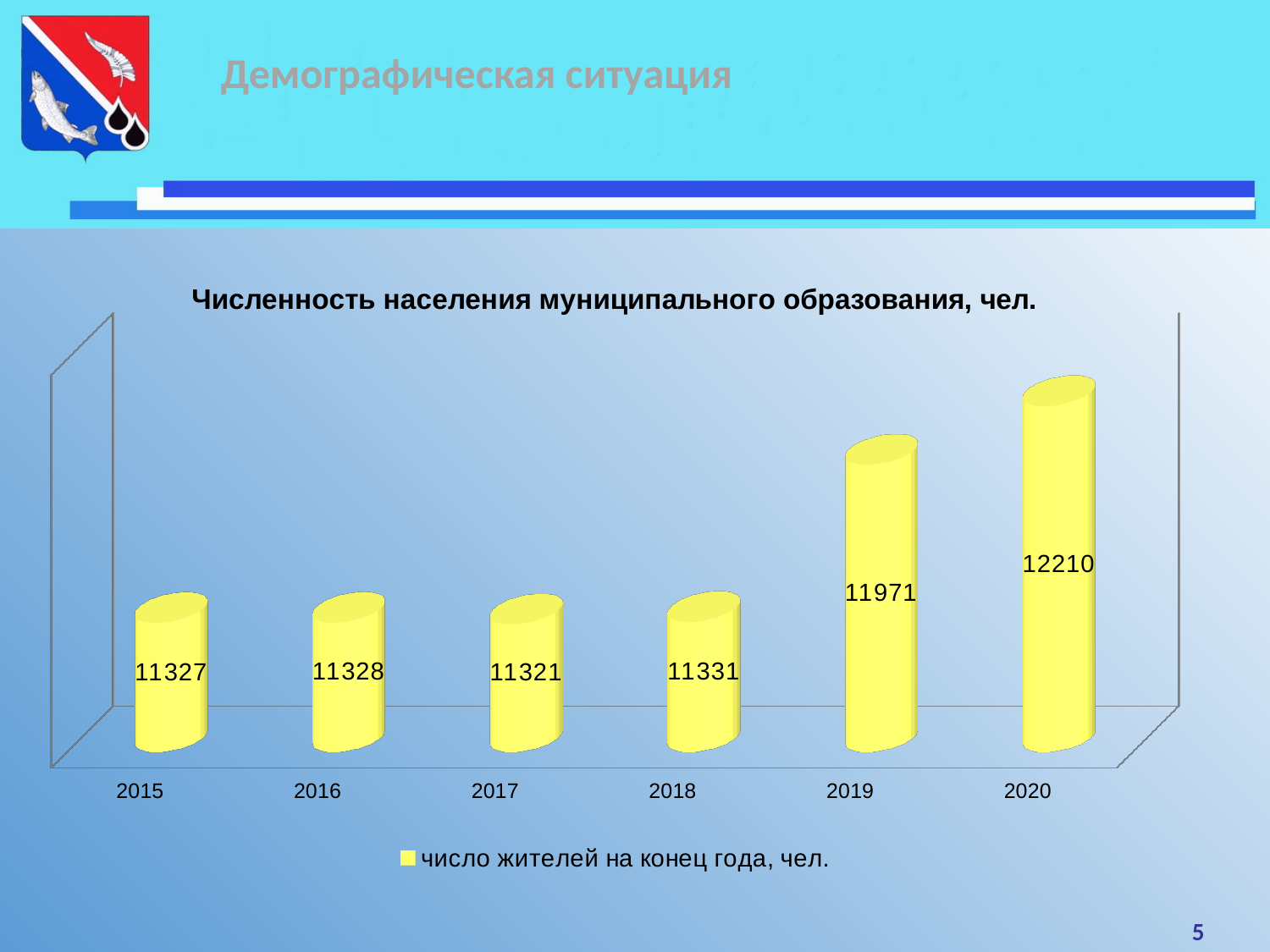
Which year has the highest population value? 2020 What is the population value shown for 2019? 11971 What is the difference between the population values for 2020 and 2019? 239 How many series does the legend list? 1 Which year has a larger population value, 2016 or 2018? 2018 What is the difference between the population values for 2019 and 2018? 640 What kind of chart is shown on the slide? bar chart How many years are shown on the x axis? 6 What is the title of the chart? Численность населения муниципального образования, чел. What is the population value shown for 2020? 12210 Which year has the lowest population value? 2017 What is the population value shown for 2015? 11327